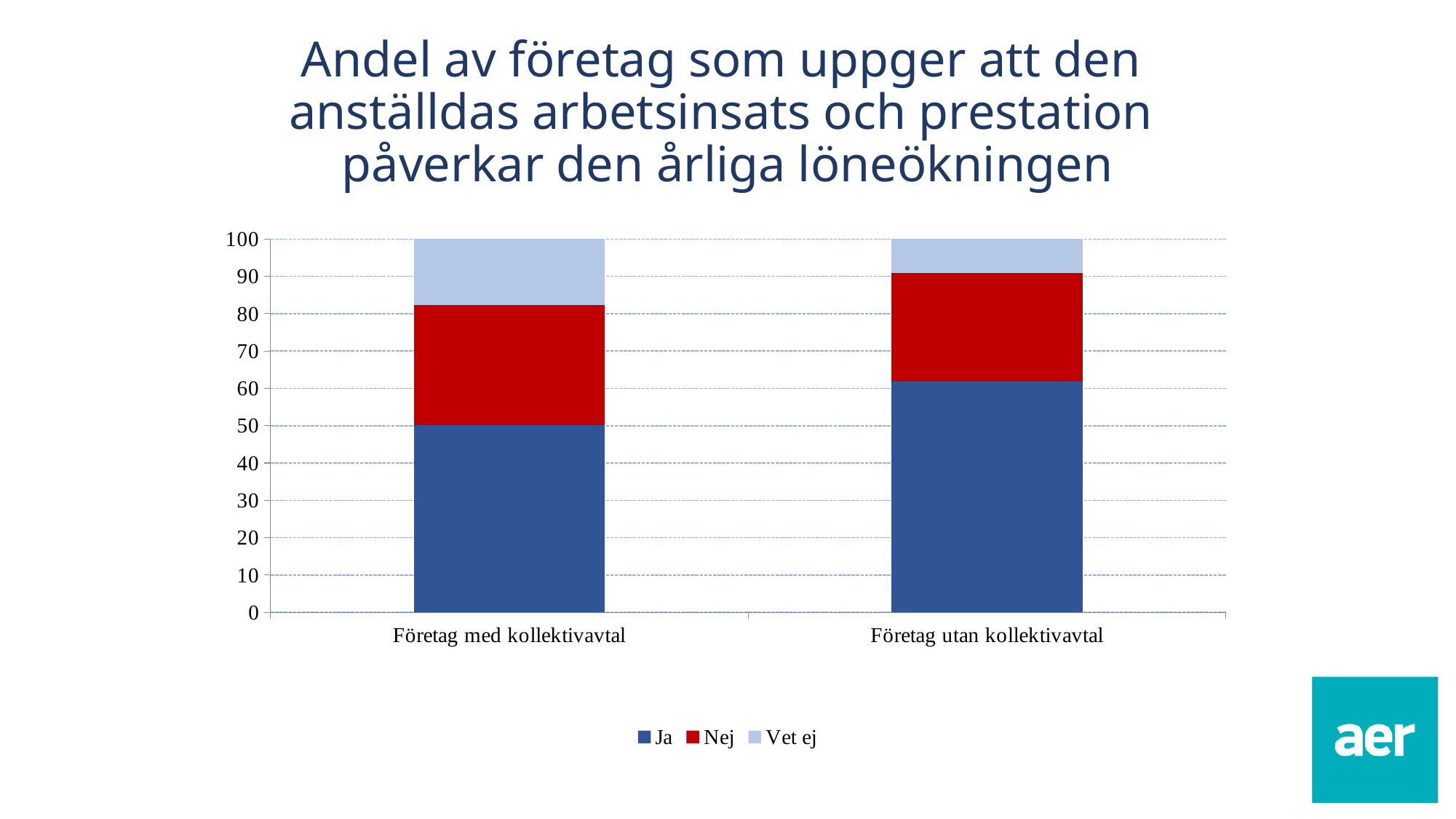
Is the Ja value for Företag med kollektivavtal greater or less than 60? less What are the series names listed in the legend? Ja, Nej, Vet ej Which category has the larger Vet ej segment, Företag med kollektivavtal or Företag utan kollektivavtal? Företag med kollektivavtal What kind of chart is shown on the slide? Stacked bar chart Which colour represents the Ja series in the chart? Dark blue What is the total height of the stacked bar for Företag utan kollektivavtal? 100 Is the Vet ej value for Företag utan kollektivavtal greater or less than 20? less How many series does the legend list? 3 Which category has the larger Ja segment, Företag med kollektivavtal or Företag utan kollektivavtal? Företag utan kollektivavtal Is the Ja value for Företag utan kollektivavtal greater or less than 50? greater How many categories are shown on the x axis? 2